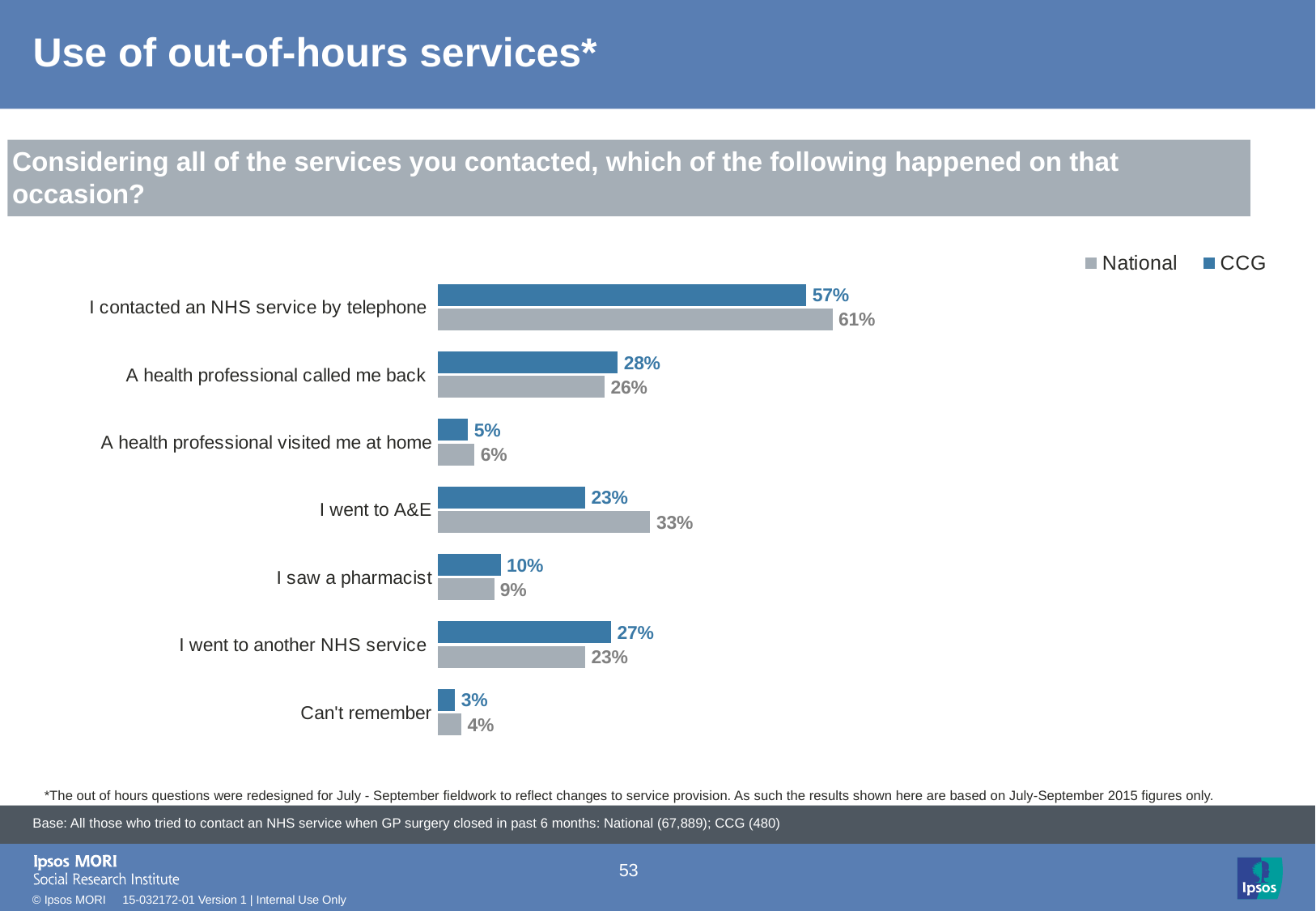
Which category has the highest CCG value? I contacted an NHS service by telephone What kind of chart is shown on the slide? Bar chart What is the CCG value for "I contacted an NHS service by telephone"? 57% Which series is shown in dark blue in the legend? CCG What is the CCG value for "I went to another NHS service"? 27% How many categories are shown in the chart? 7 Which category has the lowest National value? Can't remember What is the difference between the National and CCG values for "I went to A&E"? 10% Which is larger for "A health professional called me back": the National value or the CCG value? CCG What is the National value for "A health professional visited me at home"? 6% What is the National value for "I went to A&E"? 33% How many series does the legend list? 2